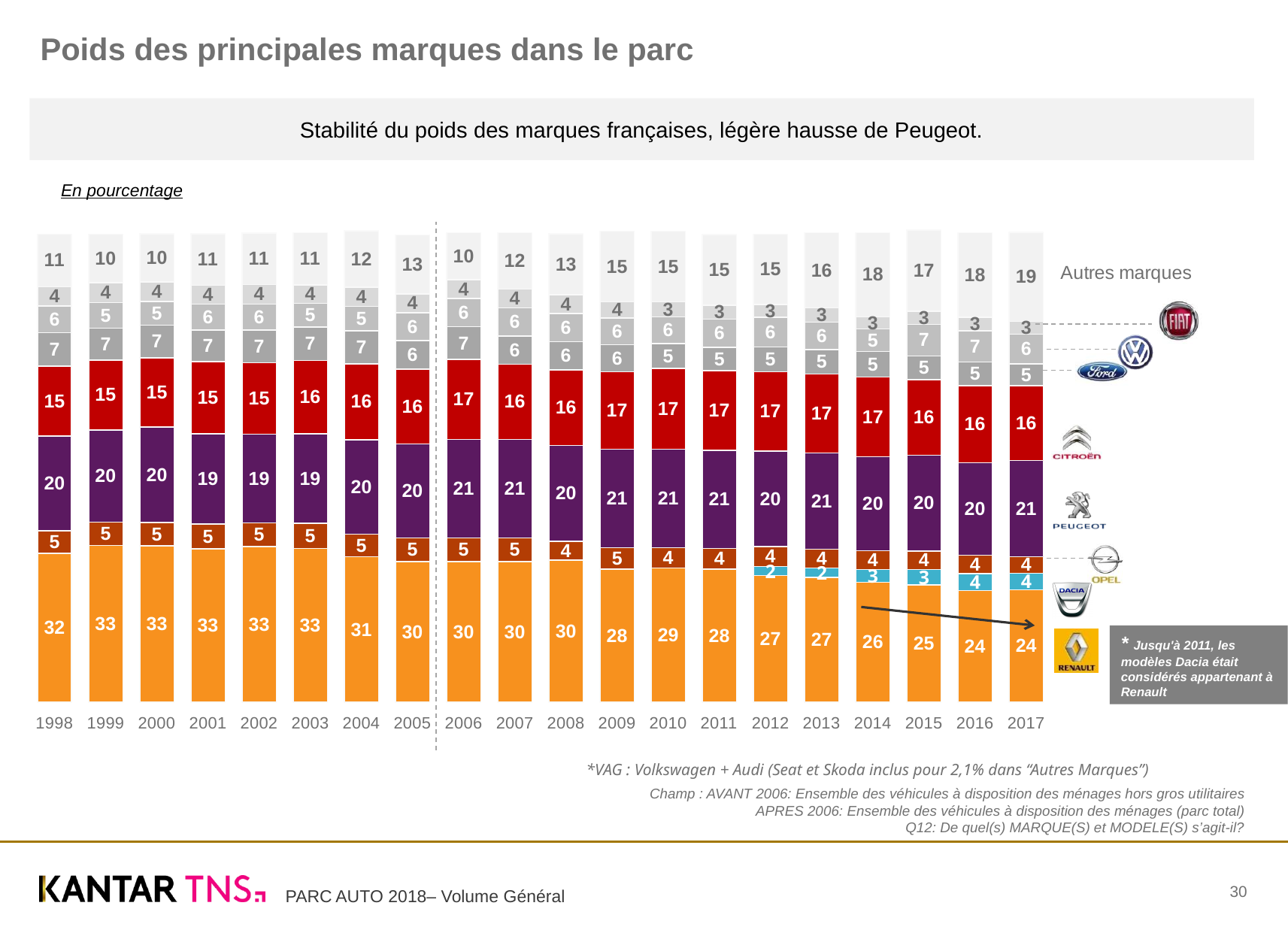
What is the value for Dacia in 2017? 4 Does the value for Renault rise or fall from 1998 to 2017? Fall What is the value for 'Autres marques' in 2017? 19 What kind of chart is shown on the slide? Stacked bar chart What is the value for Renault in 1998? 32 How many years are shown on the x axis of the chart? 20 What is the title of the chart on the slide? Poids des principales marques dans le parc In 2017, which is larger: the value for Peugeot or the value for Citroën? Peugeot What is the difference between the Renault value in 1998 and in 2017? 8 What is the value for Peugeot in 2017? 21 Does the value for 'Autres marques' rise or fall from 1998 to 2017? Rise What is the value for Renault in 2017? 24